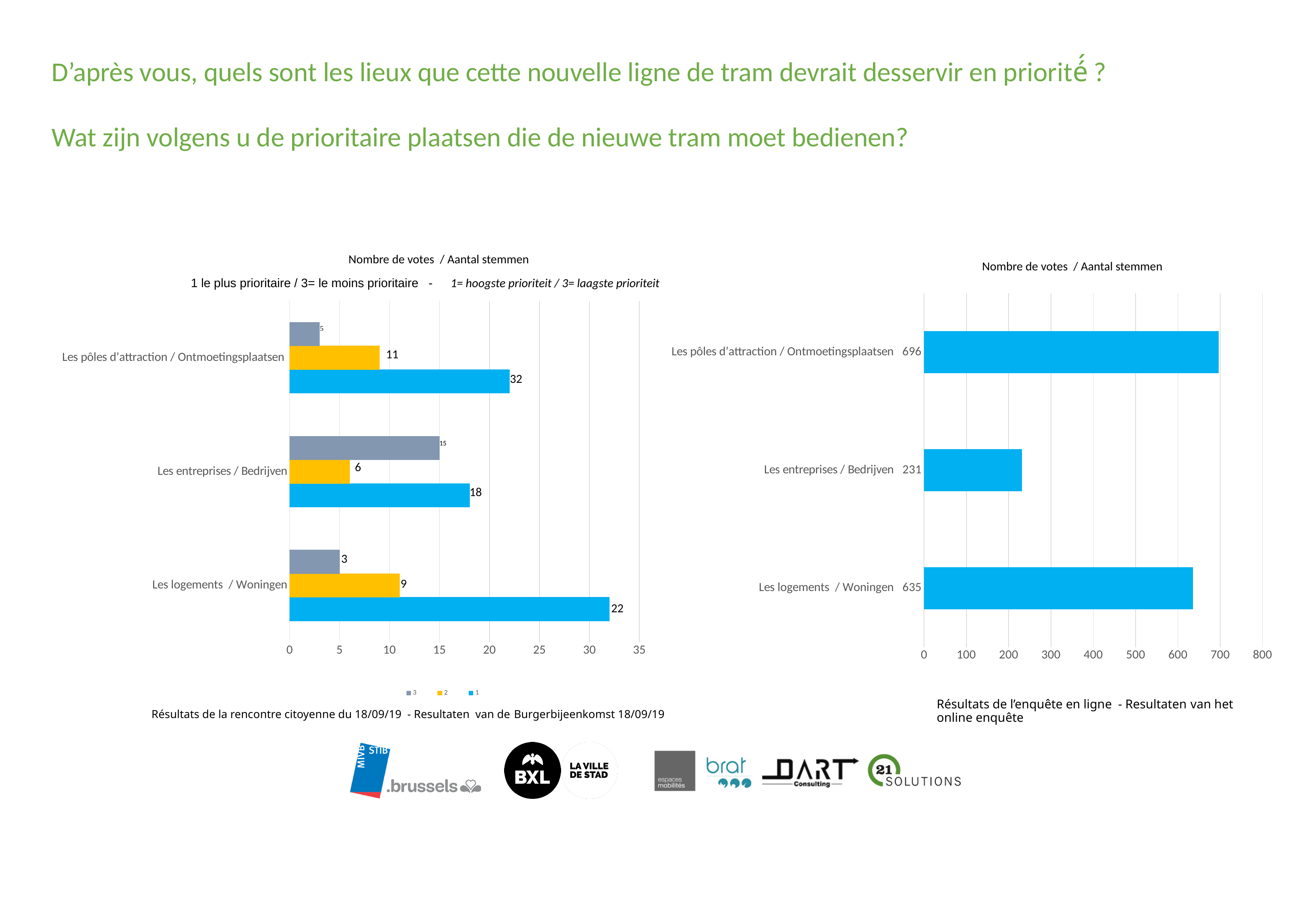
In the left chart (Résultats de la rencontre citoyenne du 18/09/19), for Les logements / Woningen, which is larger: series 3 or series 2? Series 2 In the left chart (Résultats de la rencontre citoyenne du 18/09/19), what is the value of series 1 for Les entreprises / Bedrijven? 18 In the right chart (Résultats de l'enquête en ligne), what is the difference in votes between Les pôles d'attraction / Ontmoetingsplaatsen and Les entreprises / Bedrijven? 465 In the right chart (Résultats de l'enquête en ligne), is the value for Les logements / Woningen greater or less than 600? greater What type of chart is the right chart (Résultats de l'enquête en ligne)? Bar chart In the right chart (Résultats de l'enquête en ligne), which category received the most votes? Les pôles d'attraction / Ontmoetingsplaatsen In the right chart (Résultats de l'enquête en ligne), how many categories are shown? 3 In the left chart (Résultats de la rencontre citoyenne du 18/09/19), how many series does the legend list? 3 In the right chart (Résultats de l'enquête en ligne), which category received the fewest votes? Les entreprises / Bedrijven In the left chart (Résultats de la rencontre citoyenne du 18/09/19), what is the value of series 2 for Les logements / Woningen? 9 In the left chart (Résultats de la rencontre citoyenne du 18/09/19), what is the difference between series 1 and series 2 for Les entreprises / Bedrijven? 12 In the right chart (Résultats de l'enquête en ligne), how many votes did Les entreprises / Bedrijven receive? 231